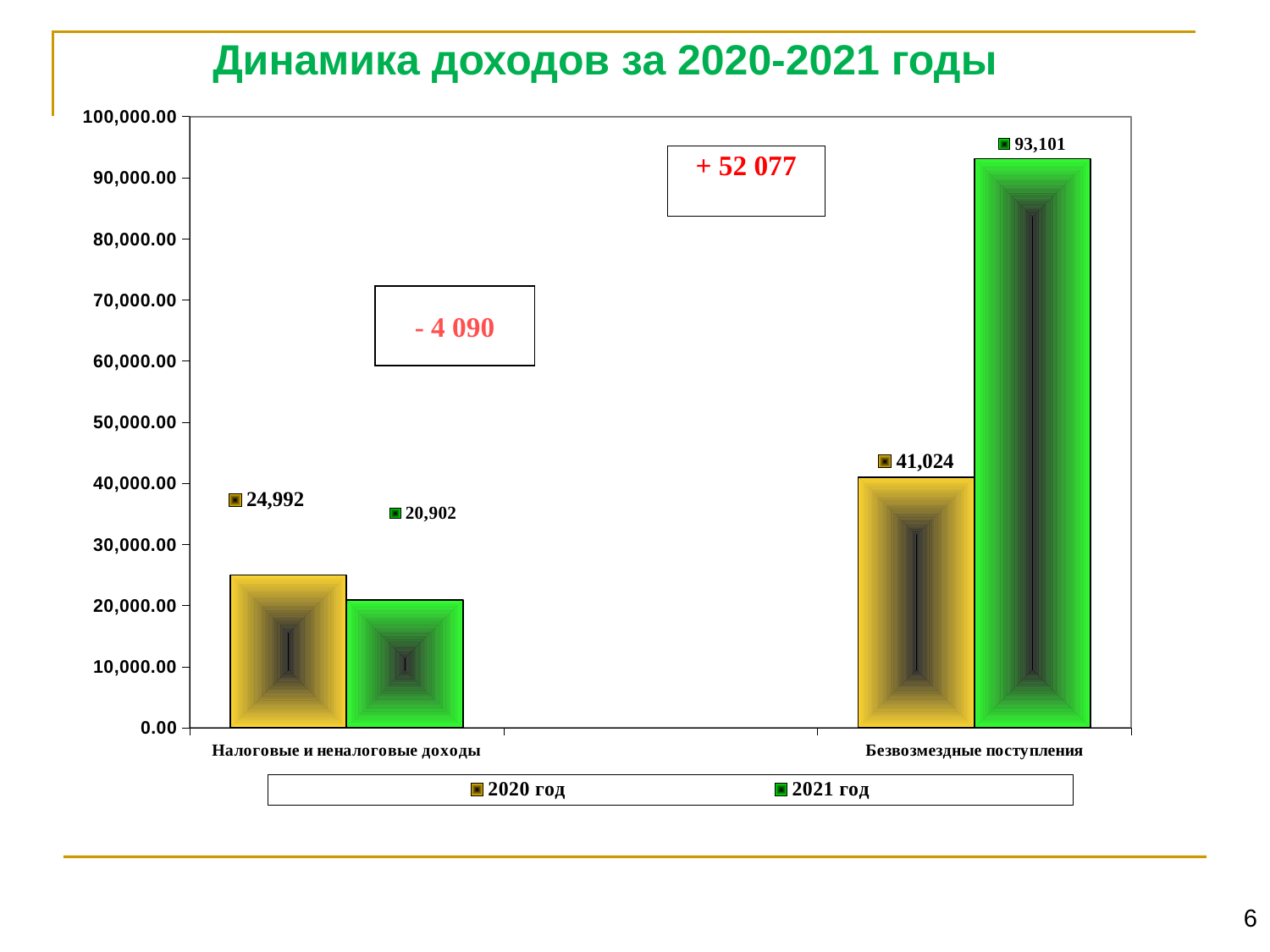
What is the value for 2020 год in the Налоговые и неналоговые доходы category? 24,992 What is the value for 2021 год in the Налоговые и неналоговые доходы category? 20,902 What kind of chart is shown on the slide? bar chart Which bar has the lowest value on the chart? 2021 год, Налоговые и неналоговые доходы What is the difference between the 2021 год and 2020 год values for Безвозмездные поступления? 52,077 Which is larger for Налоговые и неналоговые доходы: the 2020 год value or the 2021 год value? 2020 год Which bar has the highest value on the chart? 2021 год, Безвозмездные поступления Is the 2021 год value for Безвозмездные поступления greater or less than 90,000.00? greater What is the value for 2021 год in the Безвозмездные поступления category? 93,101 How many categories are shown on the x axis? 2 What is the value for 2020 год in the Безвозмездные поступления category? 41,024 How many series does the legend list? 2